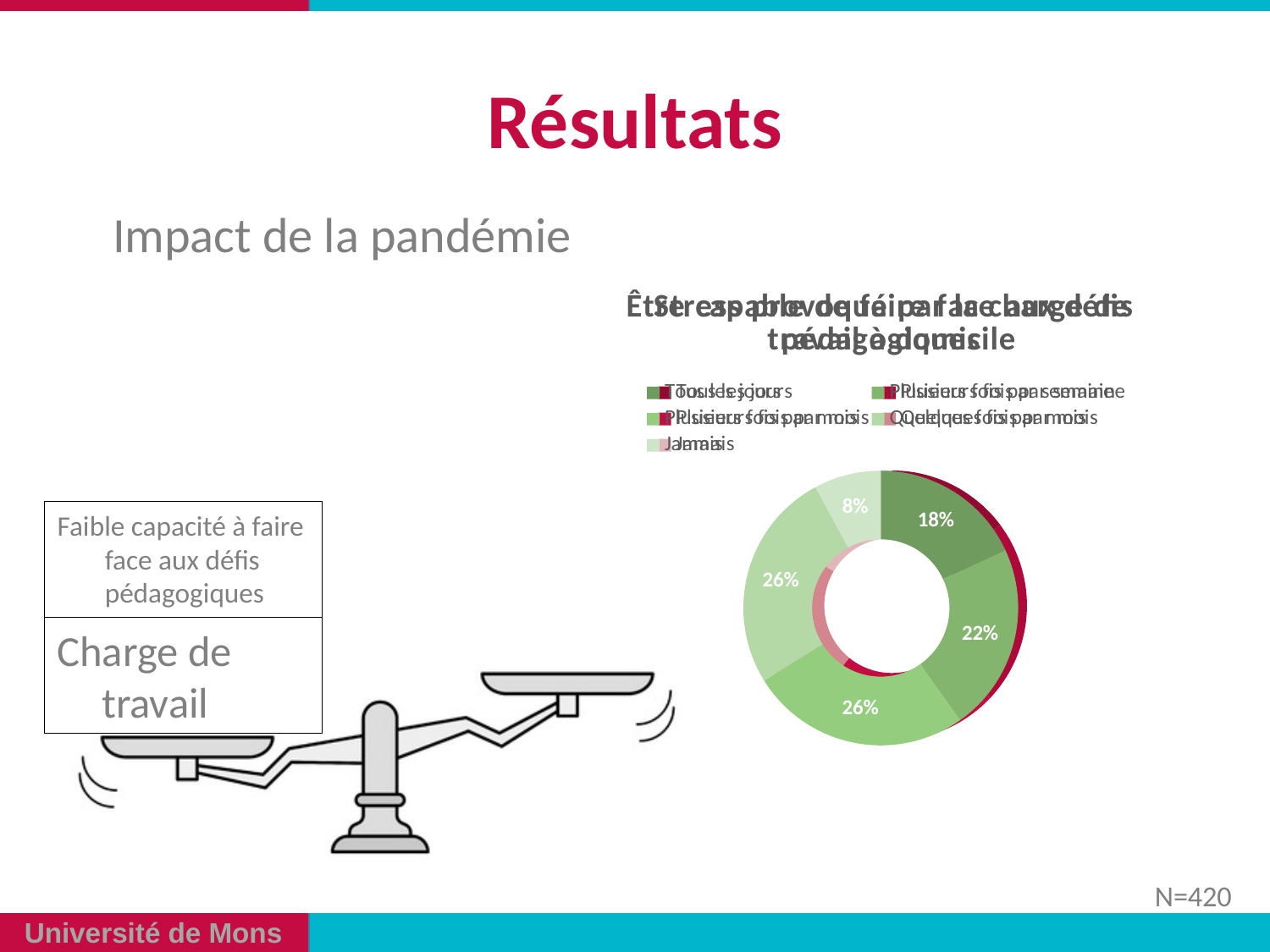
Which is larger on the doughnut chart: the slice labelled 22% or the slice labelled 18%? 22% How many slices does the doughnut chart have? 5 What kind of chart is shown on the right of the slide? doughnut (pie) chart What percentage is shown on the lightest green slice of the doughnut chart? 8% How many slices of the doughnut chart are labelled 26%? 2 What sample size (N) is indicated at the bottom right of the slide? N=420 What percentage is shown on the darkest green slice at the top of the doughnut chart? 18% What is the difference between the largest slice (26%) and the smallest slice (8%)? 18% What is the difference between the 22% slice and the 18% slice? 4% What is the largest percentage labelled on the doughnut chart? 26% What is the smallest percentage labelled on the doughnut chart? 8%